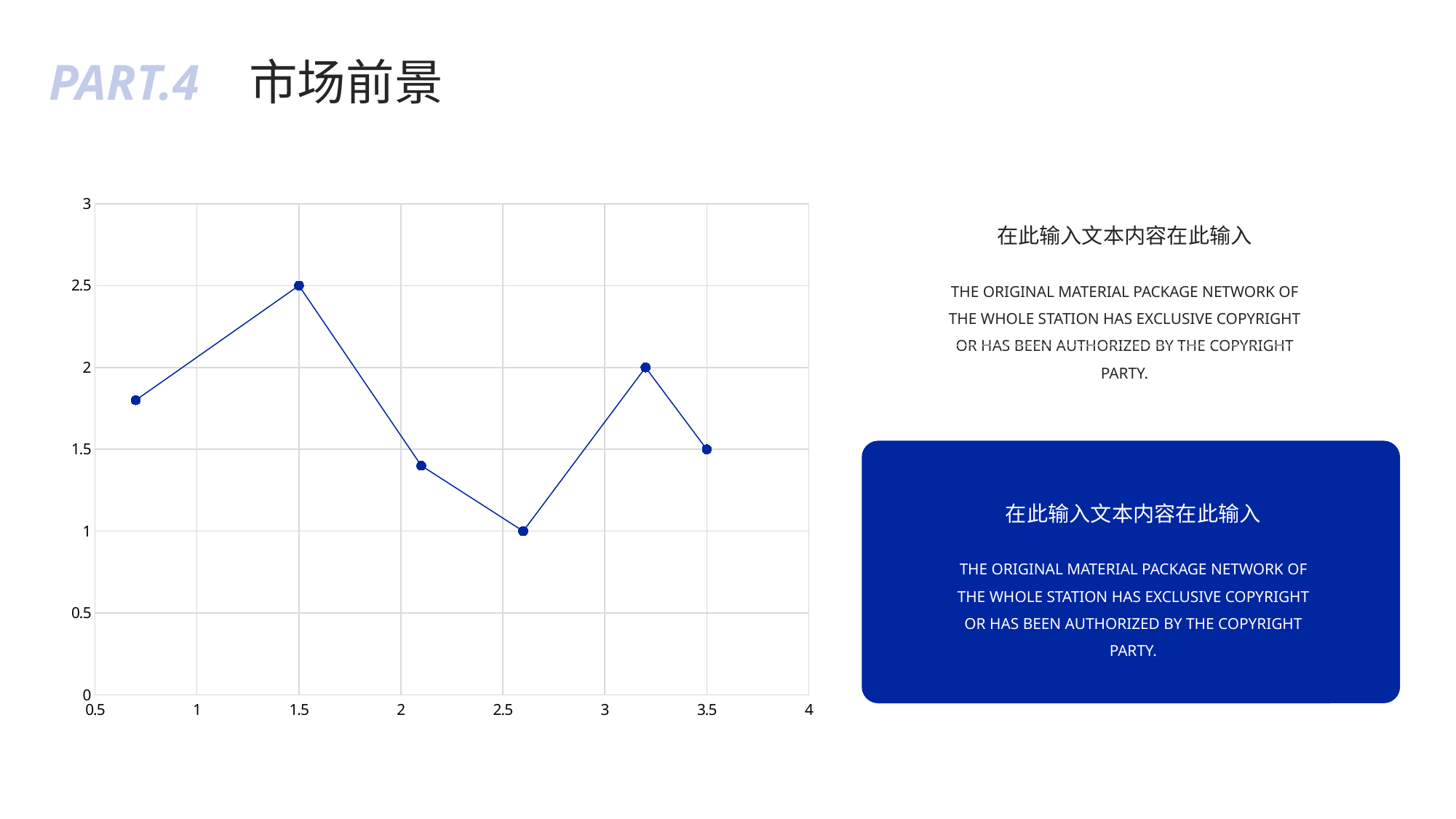
What is the y value of the lowest point on the chart? 1 How many data points are plotted on the chart? 6 Is the y value of the first (leftmost) point greater or less than 1.5? greater At which x value does the chart reach its highest point? 1.5 Do the values rise steadily from left to right along the x axis? No, they rise and fall Which is larger, the y value at x = 1.5 or the y value at x = 3.5? x = 1.5 What is the difference between the y value at x = 1.5 and the y value at x = 3.5? 1 What is the y value of the point at x = 3.5? 1.5 Is the y value of the third point from the left greater or less than 2? less What type of chart is shown on the slide? line chart Which point is the lowest on the chart, counting from the left? the fourth point What is the y value of the point at x = 1.5? 2.5